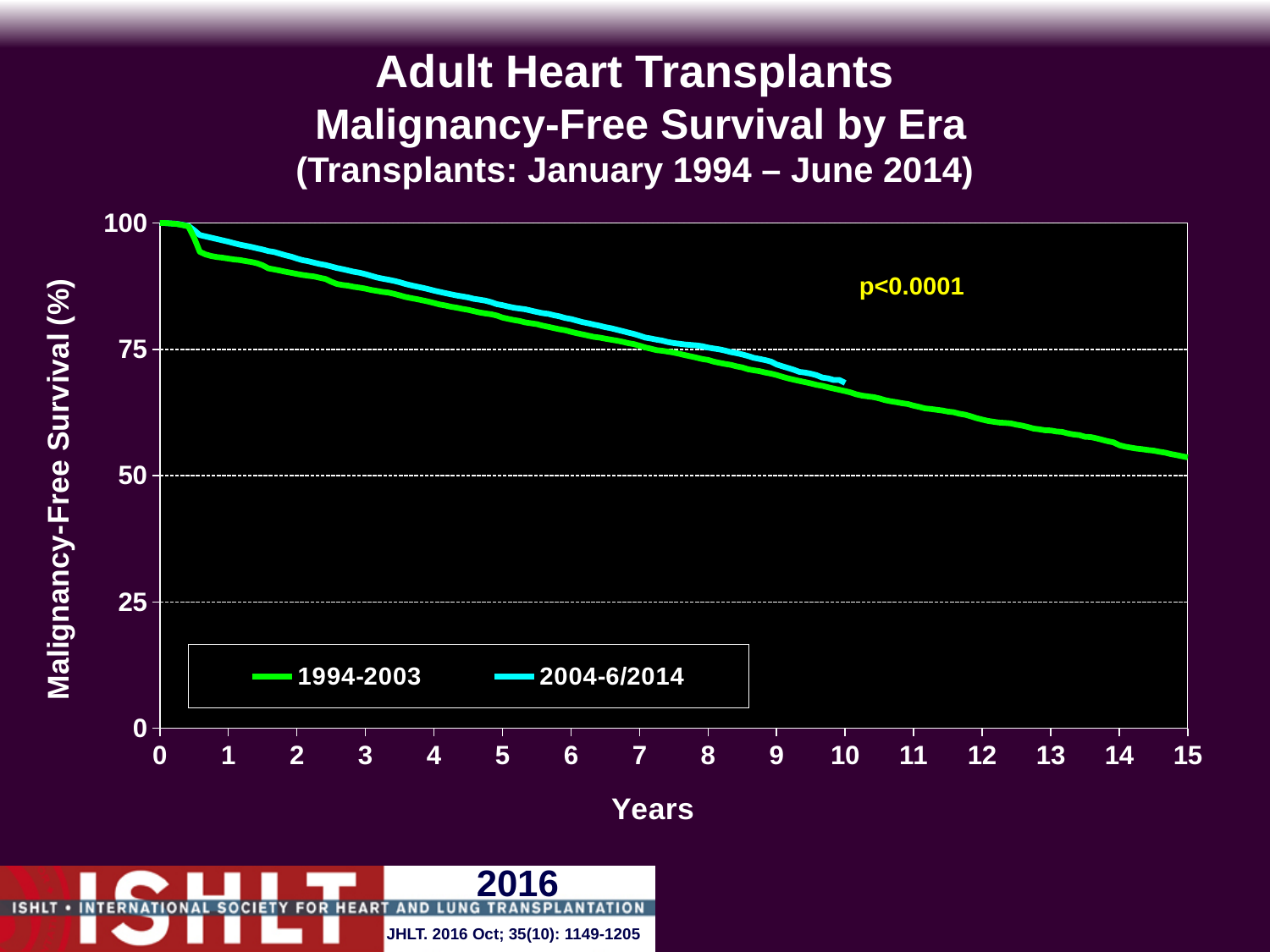
Is the value for the 1994-2003 series at 15 years greater or less than 50? greater Which two eras are listed in the legend? 1994-2003 and 2004-6/2014 How many series does the legend list? 2 Is the value for the 2004-6/2014 series at 5 years greater or less than 75? greater What kind of chart is shown on the slide? line chart Is the value for the 1994-2003 series at 10 years greater or less than 75? less Which series extends further along the x axis, 1994-2003 or 2004-6/2014? 1994-2003 At 5 years, which series has the higher malignancy-free survival, 1994-2003 or 2004-6/2014? 2004-6/2014 What is the maximum value shown on the x axis (Years)? 15 Do the survival curves rise or fall as years increase? fall What is the label of the y axis? Malignancy-Free Survival (%)